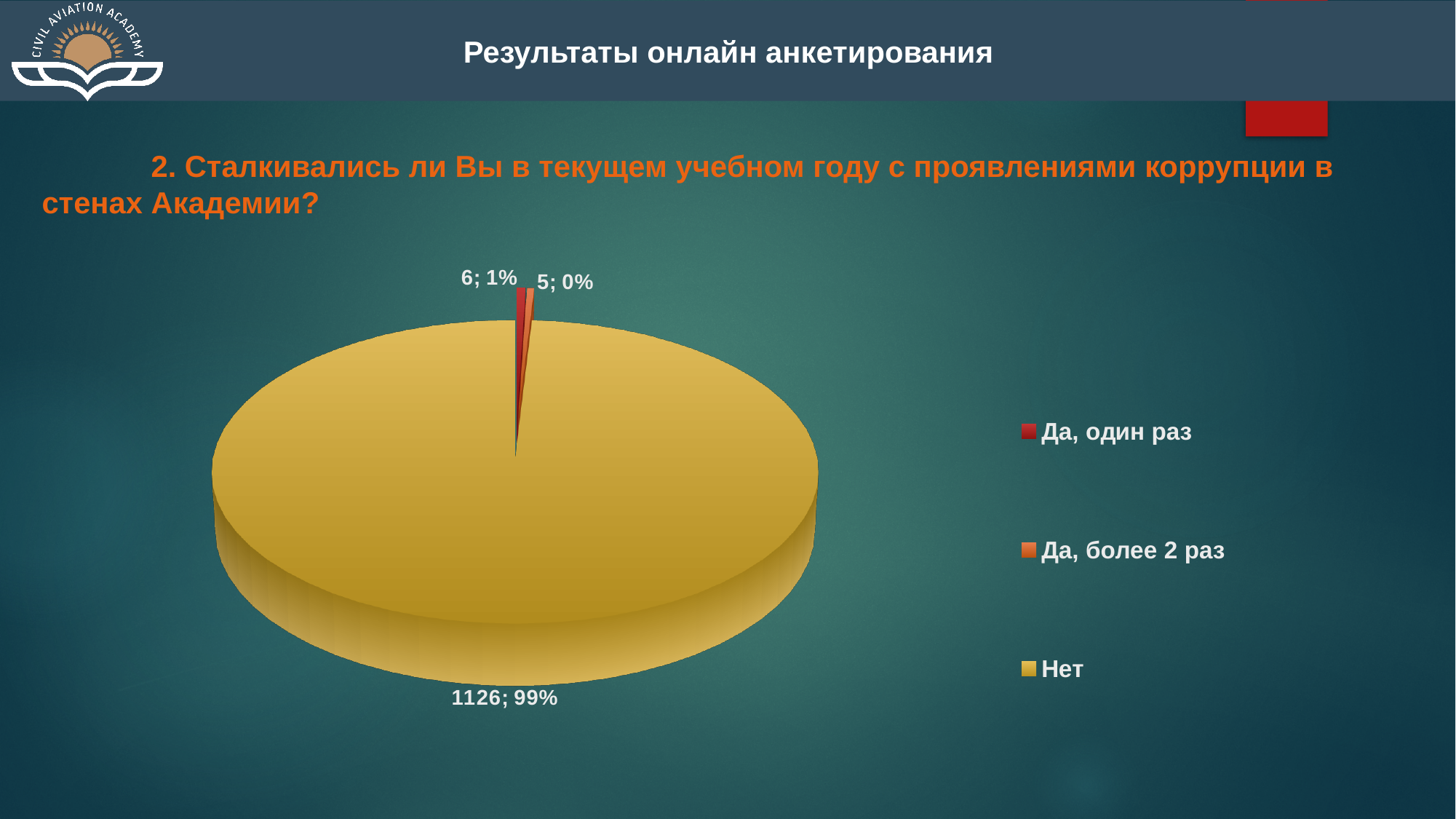
Which category has the smallest count? Да, более 2 раз What is the count for the "Да, более 2 раз" slice? 5 What is the difference between the counts for "Нет" and "Да, один раз"? 1120 What percentage share is shown for the "Да, один раз" slice? 1% What percentage share does the "Нет" slice have? 99% What colour is the "Нет" slice? yellow What is the count for the "Нет" slice? 1126 What is the count for the "Да, один раз" slice? 6 What kind of chart is shown on the slide? pie chart How many slices does the pie chart have? 3 How many entries does the legend list? 3 Which category has the largest slice? Нет